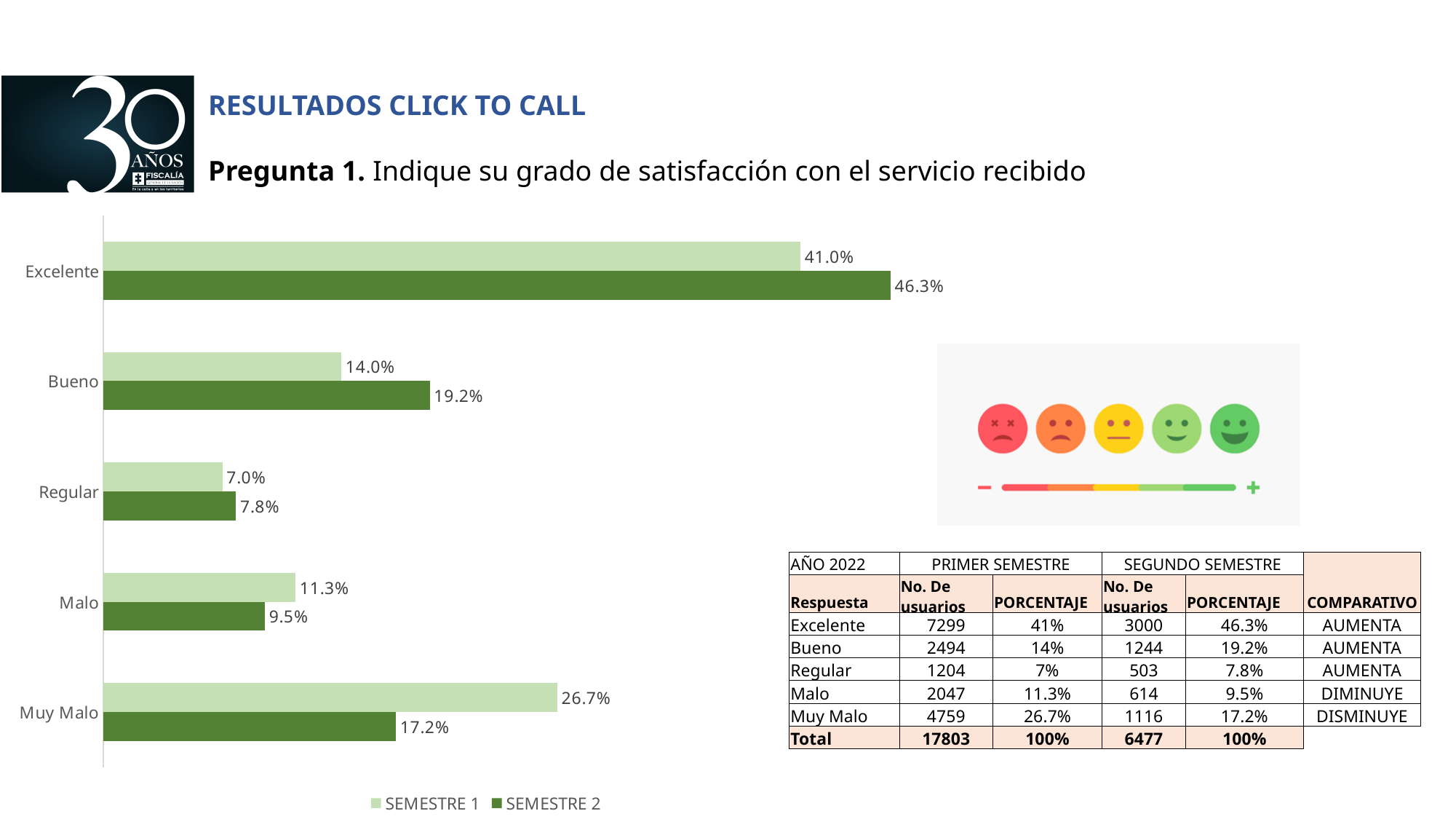
What kind of chart is shown on the slide? Bar chart How many series does the legend list? 2 What is the SEMESTRE 1 value for Bueno? 14.0% What is the difference between the SEMESTRE 2 and SEMESTRE 1 values for Bueno? 5.2% For Muy Malo, which series has the larger value, SEMESTRE 1 or SEMESTRE 2? SEMESTRE 1 What is the SEMESTRE 2 value for Excelente? 46.3% Which category has the lowest SEMESTRE 2 value? Regular Which series is drawn in the darker green colour? SEMESTRE 2 How many categories are shown on the chart? 5 What is the SEMESTRE 1 value for Muy Malo? 26.7% Which category has the highest SEMESTRE 1 value? Excelente What is the SEMESTRE 2 value for Malo? 9.5%